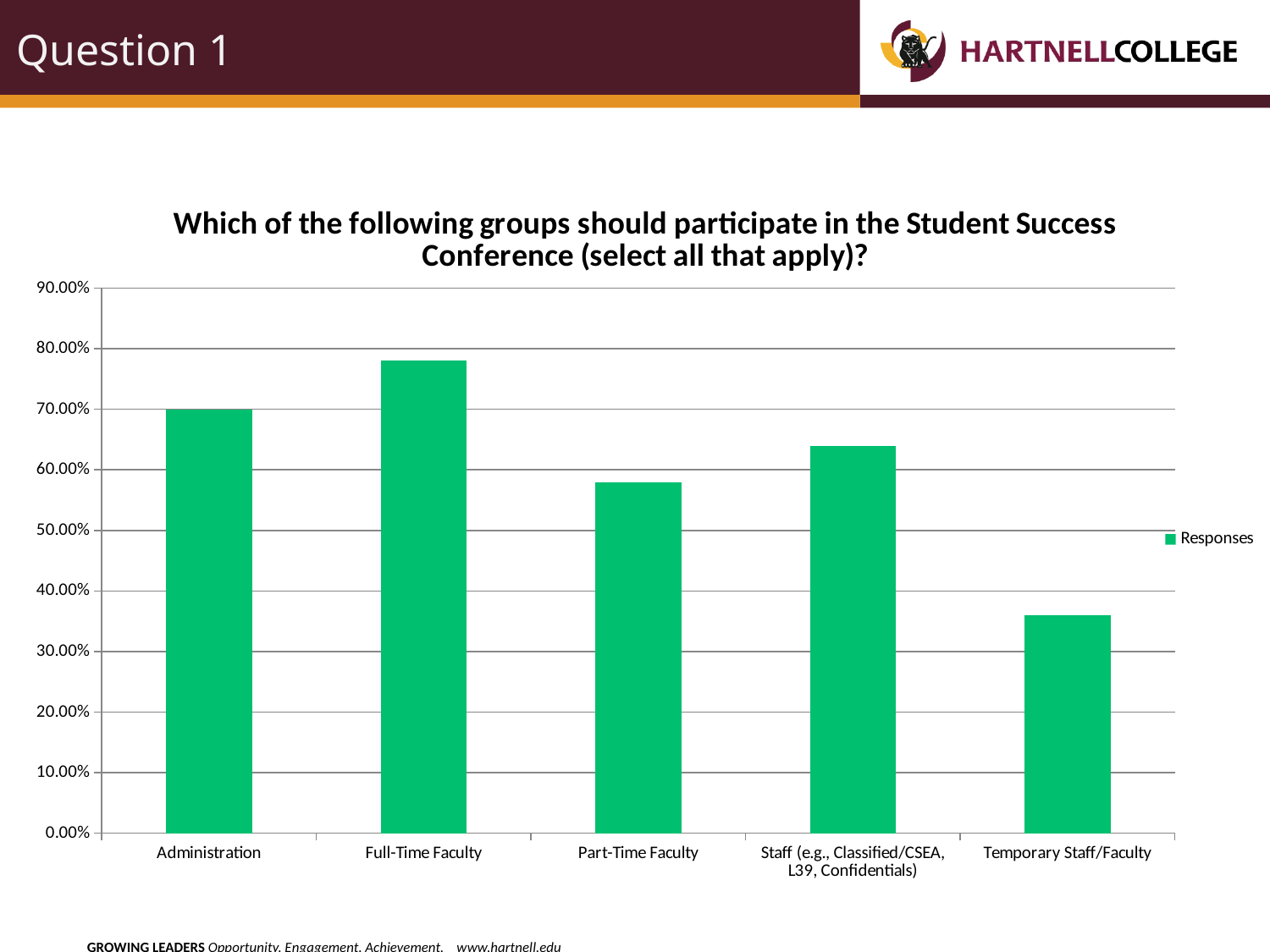
Which category has the lowest value in the chart? Temporary Staff/Faculty What type of chart is shown on the slide? bar chart Which category has the highest value in the chart? Full-Time Faculty How many series does the chart legend list? 1 How many categories are shown on the x axis of the chart? 5 Is the value for Part-Time Faculty greater or less than 50.00%? greater What is the name of the series shown in the chart legend? Responses Is the value for Staff (e.g., Classified/CSEA, L39, Confidentials) greater or less than 70.00%? less Is the value for Temporary Staff/Faculty greater or less than 40.00%? less Which has a larger value, Administration or Part-Time Faculty? Administration Which has a larger value, Staff (e.g., Classified/CSEA, L39, Confidentials) or Temporary Staff/Faculty? Staff (e.g., Classified/CSEA, L39, Confidentials)